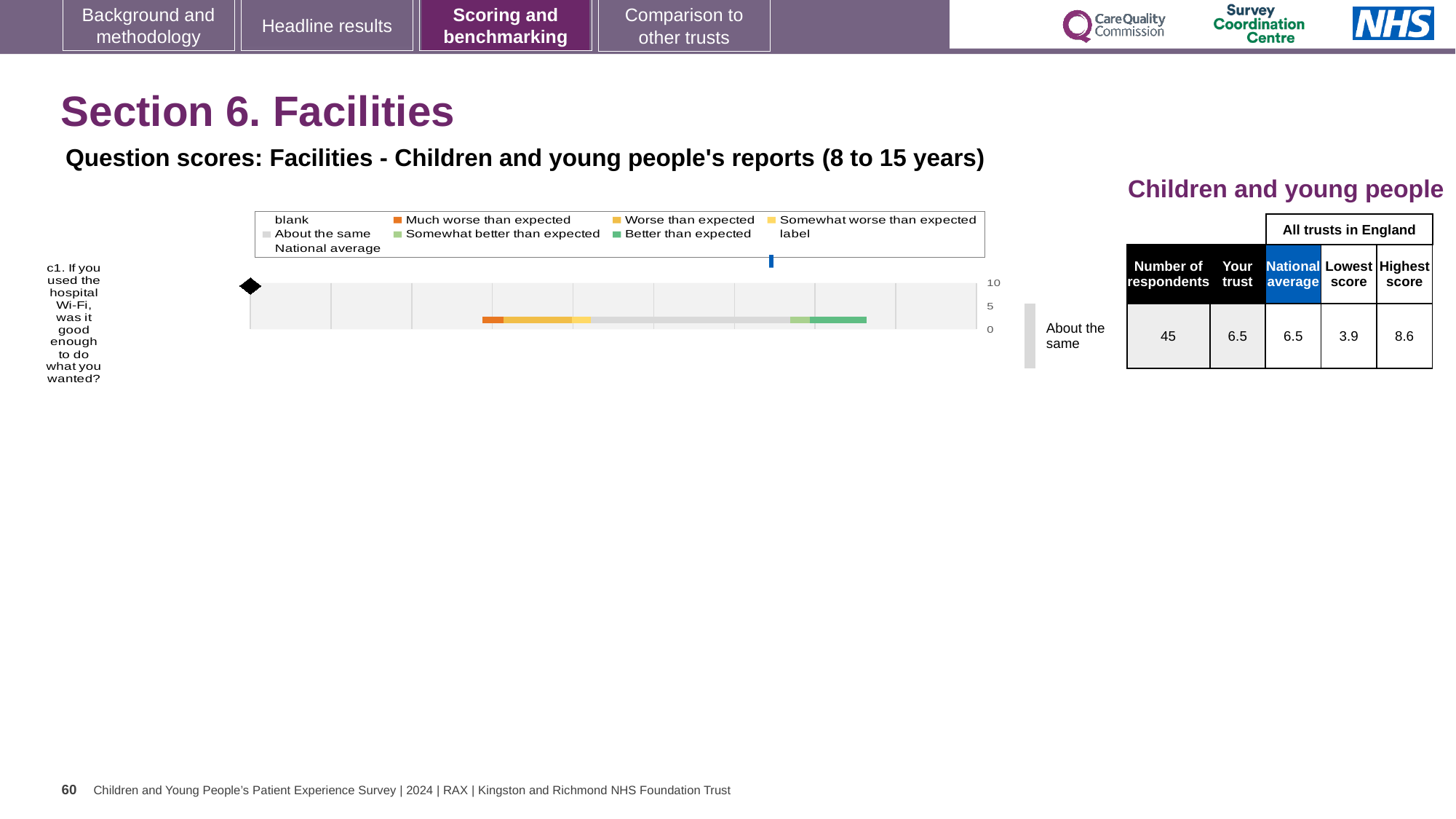
What colour represents 'Much worse than expected' in the legend? Orange Is the trust's score for question c1 greater or less than 5? greater How many respondents answered question c1? 45 What is the national average score for question c1? 6.5 What is the difference between the highest and lowest trust scores for question c1? 4.7 How many survey questions are plotted in the chart? 1 What is the trust's score for question c1 (hospital Wi-Fi)? 6.5 What is the difference between the trust's score and the national average for question c1? 0 What kind of chart is shown on the slide? Bar chart What is the lowest score among all trusts in England for question c1? 3.9 Which benchmark category does the trust's result for question c1 fall into? About the same What is the highest score among all trusts in England for question c1? 8.6